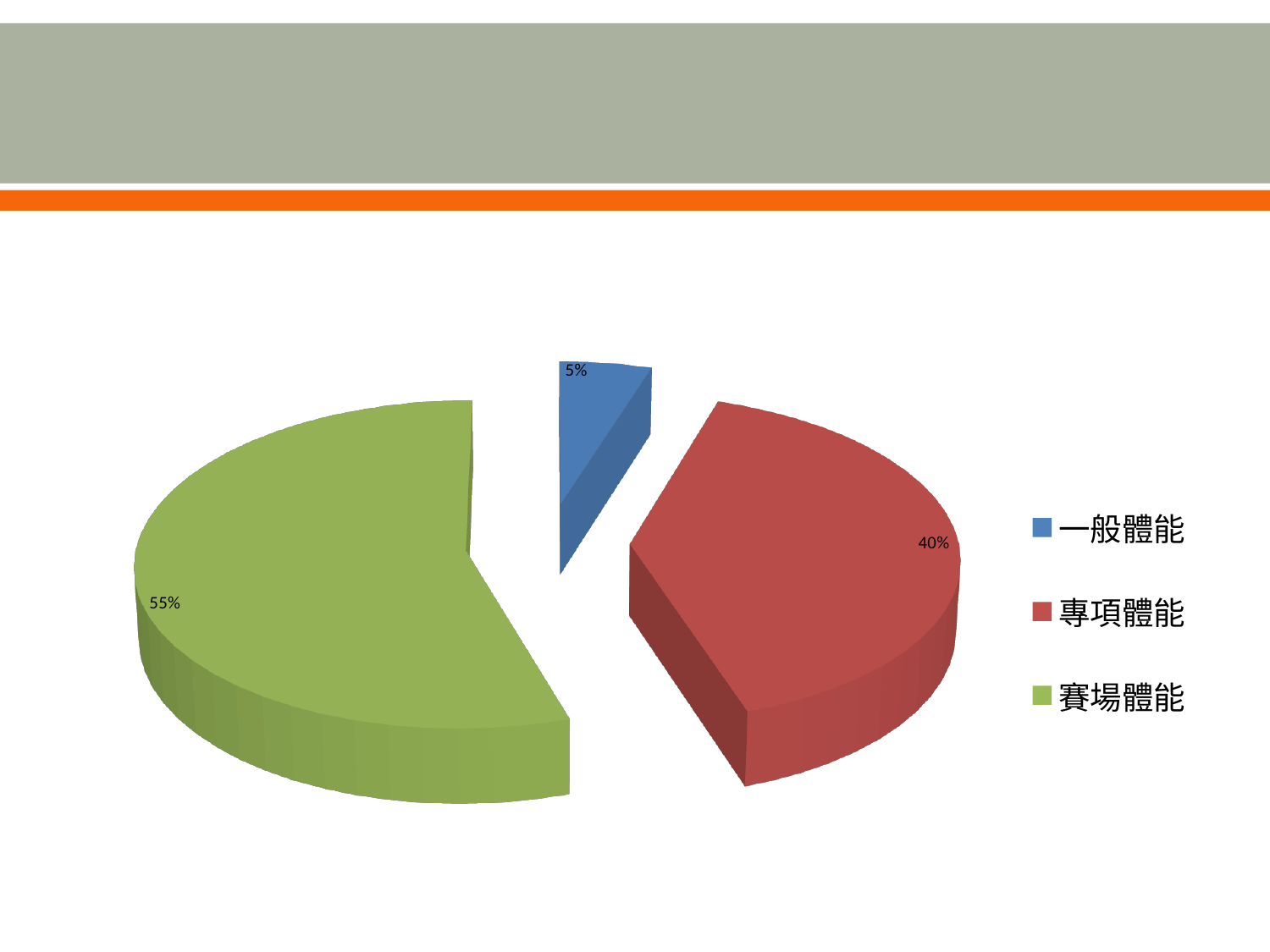
What is the difference in percentage points between 賽場體能 and 專項體能? 15 What share of the pie does 賽場體能 have? 55% Which is larger, the slice for 專項體能 or the slice for 一般體能? 專項體能 What colour is the slice for 賽場體能? Green What share of the pie does 專項體能 have? 40% What share of the pie does 一般體能 have? 5% Which category has the smallest slice of the pie? 一般體能 What kind of chart is shown on the slide? Pie chart Which category is shown in blue in the legend? 一般體能 How many slices does the pie chart have? 3 What is the difference in percentage points between 專項體能 and 一般體能? 35 Which category has the largest slice of the pie? 賽場體能